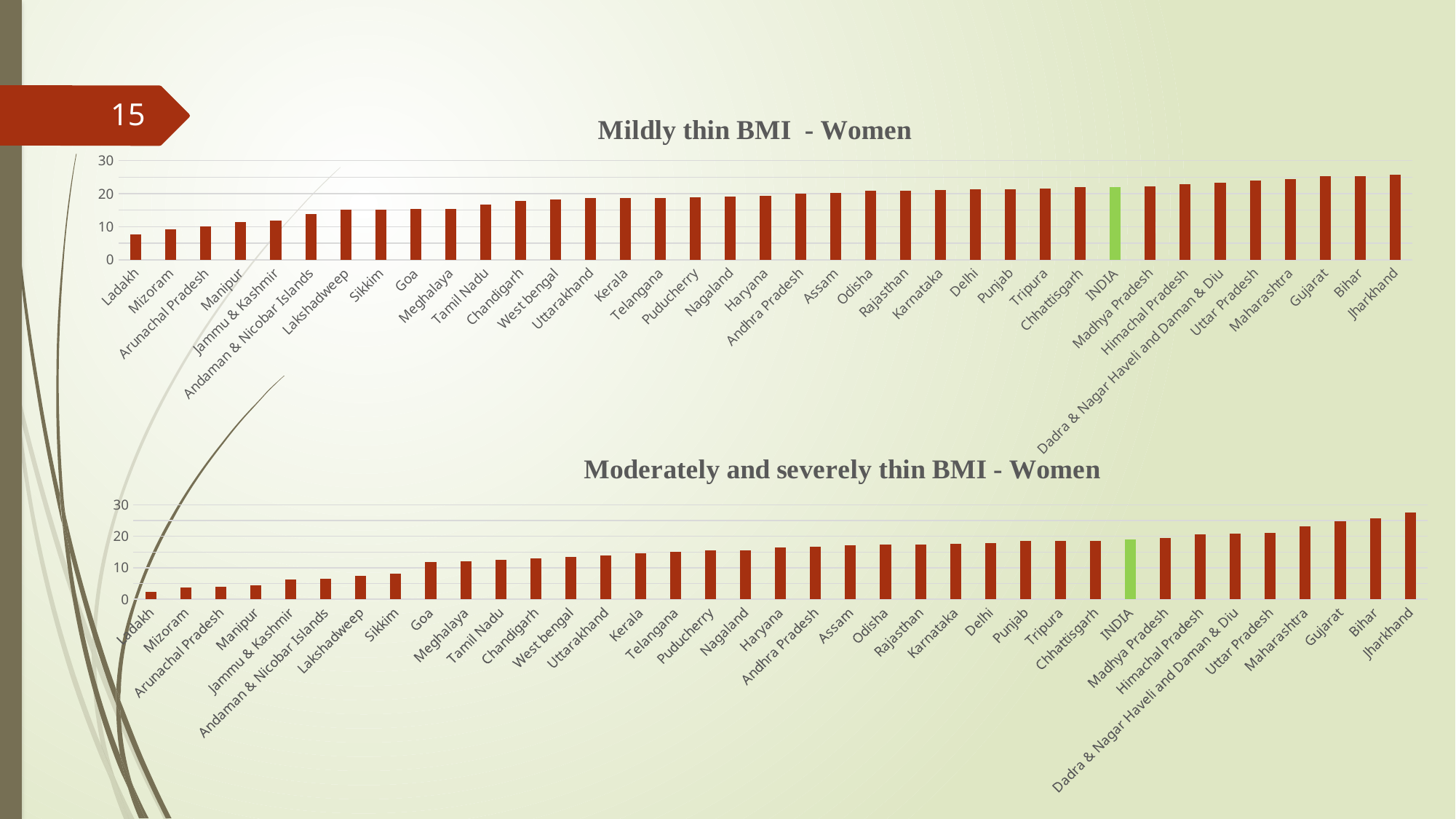
In the 'Mildly thin BMI - Women' chart, which category has the highest value? Jharkhand Do the values in the 'Mildly thin BMI - Women' chart rise or fall from left to right along the x axis? rise In the 'Mildly thin BMI - Women' chart, which category has the lowest value? Ladakh In the 'Moderately and severely thin BMI - Women' chart, which category has the lowest value? Ladakh In the 'Moderately and severely thin BMI - Women' chart, is the value for Sikkim greater or less than 10? less In the 'Moderately and severely thin BMI - Women' chart, is the value for Jharkhand greater or less than 20? greater In the 'Mildly thin BMI - Women' chart, is the value for Ladakh greater or less than 10? less In the 'Mildly thin BMI - Women' chart, which is larger, the value for Bihar or the value for Mizoram? Bihar What kind of chart is the 'Mildly thin BMI - Women' chart? bar chart In the 'Moderately and severely thin BMI - Women' chart, which category is shown with a green bar instead of a red one? INDIA In the 'Moderately and severely thin BMI - Women' chart, which is larger, the value for Goa or the value for Gujarat? Gujarat In the 'Moderately and severely thin BMI - Women' chart, which category has the highest value? Jharkhand